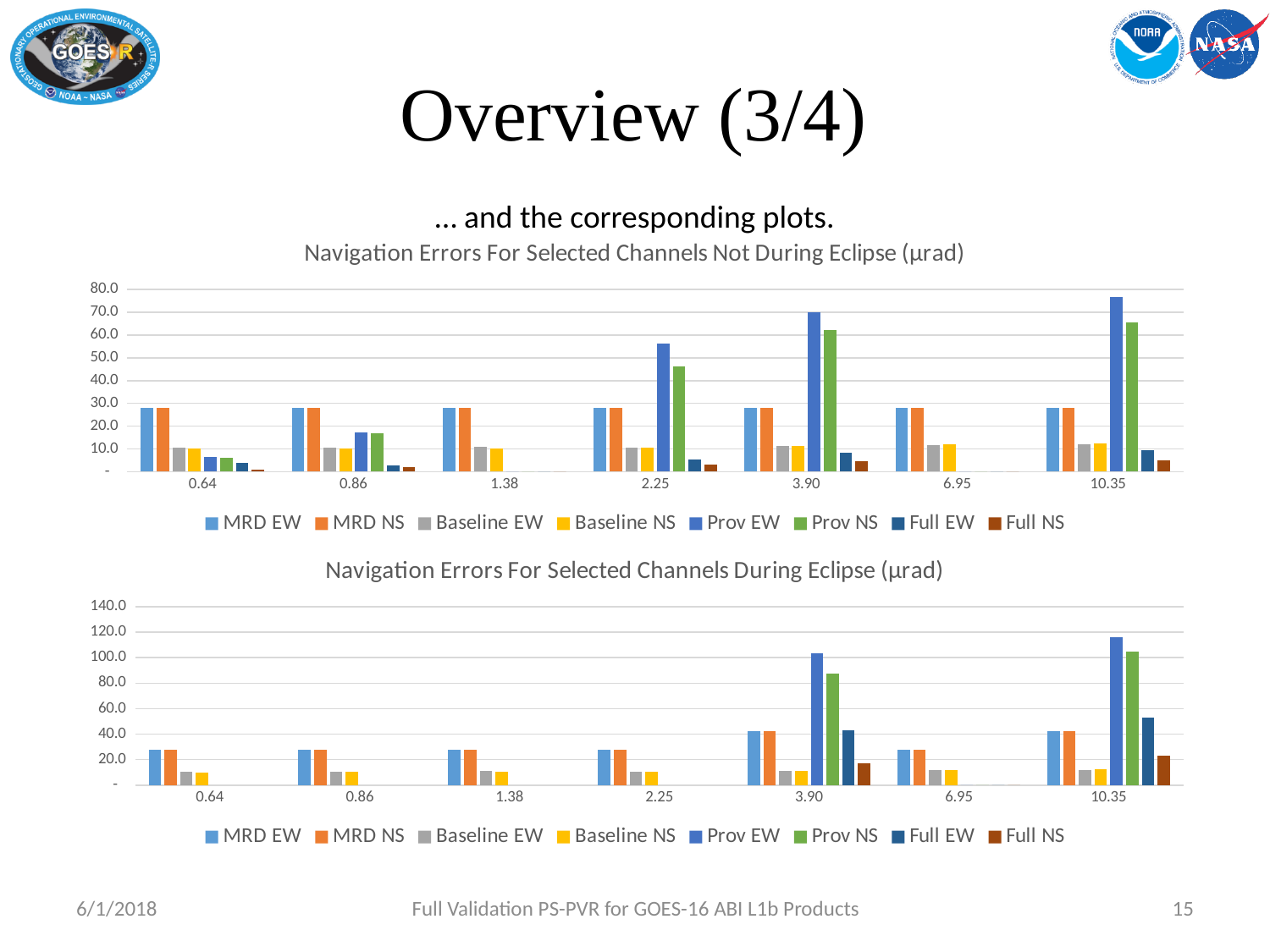
In the bottom chart (During Eclipse), which channel category has the tallest bar overall? 10.35 In the top chart (Not During Eclipse), for channel 10.35, which is larger: Prov EW or Prov NS? Prov EW In the top chart (Not During Eclipse), is the Prov NS value for 0.86 greater or less than 20.0? less In the bottom chart (During Eclipse), for channel 3.90, which is larger: Prov EW or Prov NS? Prov EW How many channel categories are shown on the x axis of the top chart (Not During Eclipse)? 7 In the top chart (Not During Eclipse), is the Prov EW value for 3.90 greater or less than 60.0? greater In the top chart (Not During Eclipse), is the Prov EW value for 2.25 greater or less than 50.0? greater How many series does the legend of the bottom chart (During Eclipse) list? 8 In the top chart (Not During Eclipse), which channel category has the tallest bar overall? 10.35